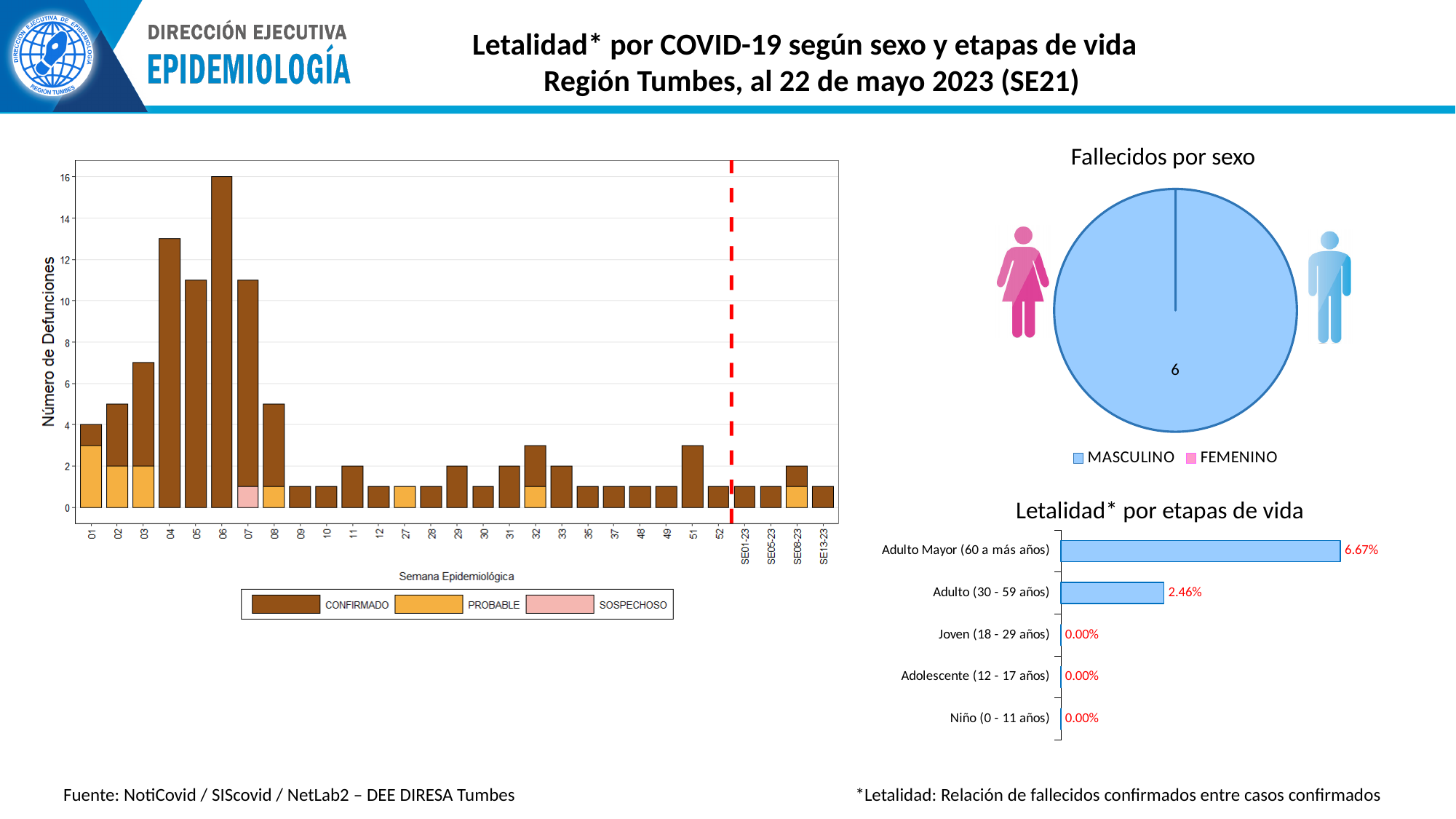
What kind of chart is 'Letalidad* por etapas de vida'? bar chart In the 'Letalidad* por etapas de vida' chart, what is the value for Adulto (30 - 59 años)? 2.46% In the bar chart on the left (Número de Defunciones by Semana Epidemiológica), is the value for week 04 greater or less than 12? greater In the 'Fallecidos por sexo' chart, what value is printed on the MASCULINO slice? 6 In the bar chart on the left (Número de Defunciones by Semana Epidemiológica), how many series does the legend list? 3 What kind of chart is 'Fallecidos por sexo'? pie chart In the 'Letalidad* por etapas de vida' chart, how many age groups are shown? 5 In the 'Letalidad* por etapas de vida' chart, what is the value for Adulto Mayor (60 a más años)? 6.67% In the 'Letalidad* por etapas de vida' chart, which age group has the highest value? Adulto Mayor (60 a más años) In the bar chart on the left (Número de Defunciones by Semana Epidemiológica), which week has the highest total number of deaths? 06 In the 'Letalidad* por etapas de vida' chart, what is the difference between the values for Adulto Mayor (60 a más años) and Adulto (30 - 59 años)? 4.21% In the 'Fallecidos por sexo' chart, how many entries does the legend list? 2